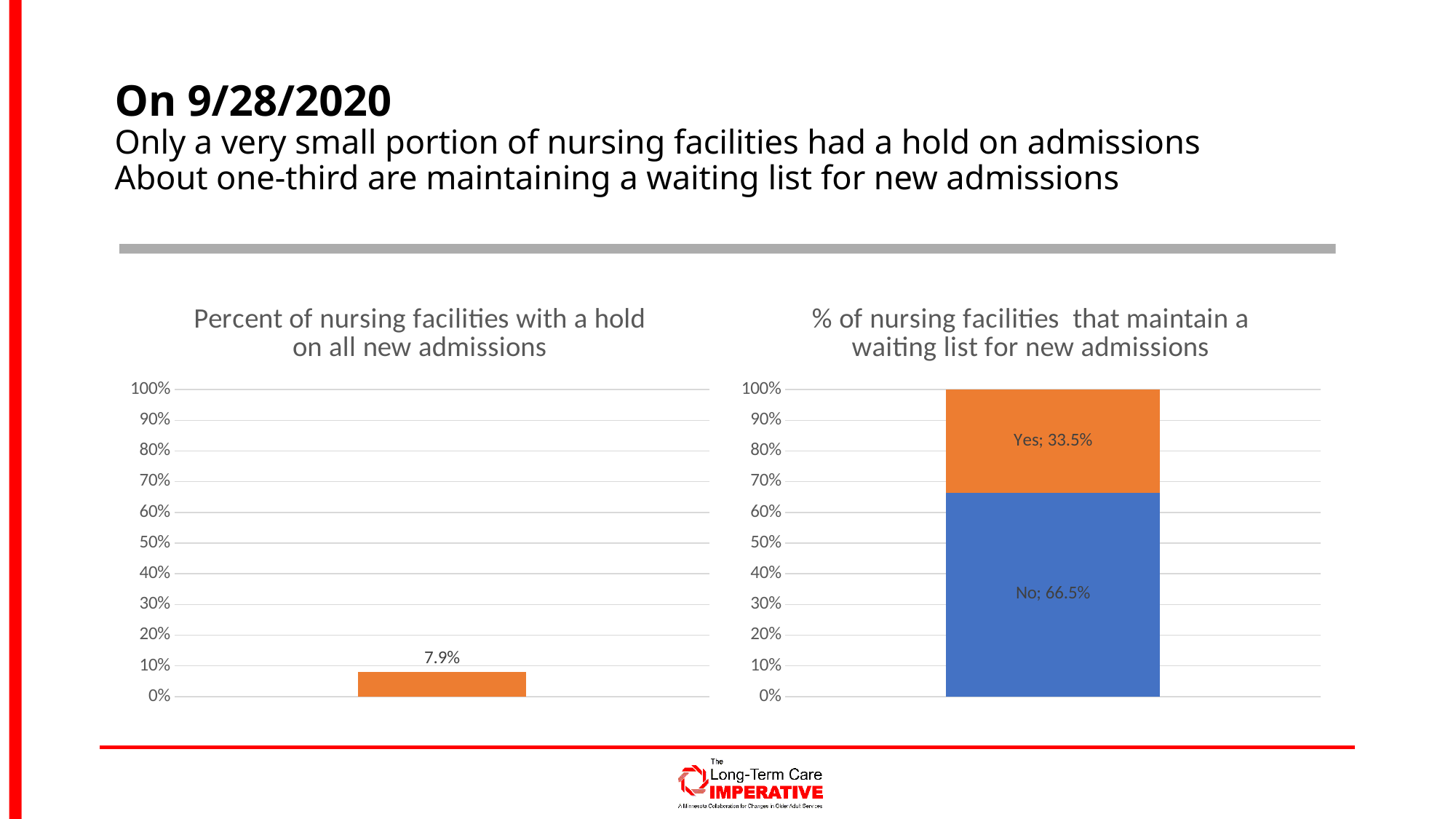
In the right chart, '% of nursing facilities that maintain a waiting list for new admissions', what is the value for 'No'? 66.5% In the right chart, '% of nursing facilities that maintain a waiting list for new admissions', what is the difference between the 'No' and 'Yes' values? 33.0% In the left chart, 'Percent of nursing facilities with a hold on all new admissions', what value is shown on the bar? 7.9% In the right chart, '% of nursing facilities that maintain a waiting list for new admissions', what is the value for 'Yes'? 33.5% How many bars are plotted in the left chart, 'Percent of nursing facilities with a hold on all new admissions'? 1 What is the highest value shown on the vertical axis of the left chart, 'Percent of nursing facilities with a hold on all new admissions'? 100% In the right chart, '% of nursing facilities that maintain a waiting list for new admissions', what colour is the 'No' segment? blue In the left chart, 'Percent of nursing facilities with a hold on all new admissions', is the bar's value greater or less than 10%? less In the right chart, '% of nursing facilities that maintain a waiting list for new admissions', which segment is larger, 'Yes' or 'No'? No What kind of chart is the right chart, '% of nursing facilities that maintain a waiting list for new admissions'? stacked bar chart In the right chart, '% of nursing facilities that maintain a waiting list for new admissions', what is the total of the stacked bar? 100% What kind of chart is the left chart, 'Percent of nursing facilities with a hold on all new admissions'? bar chart